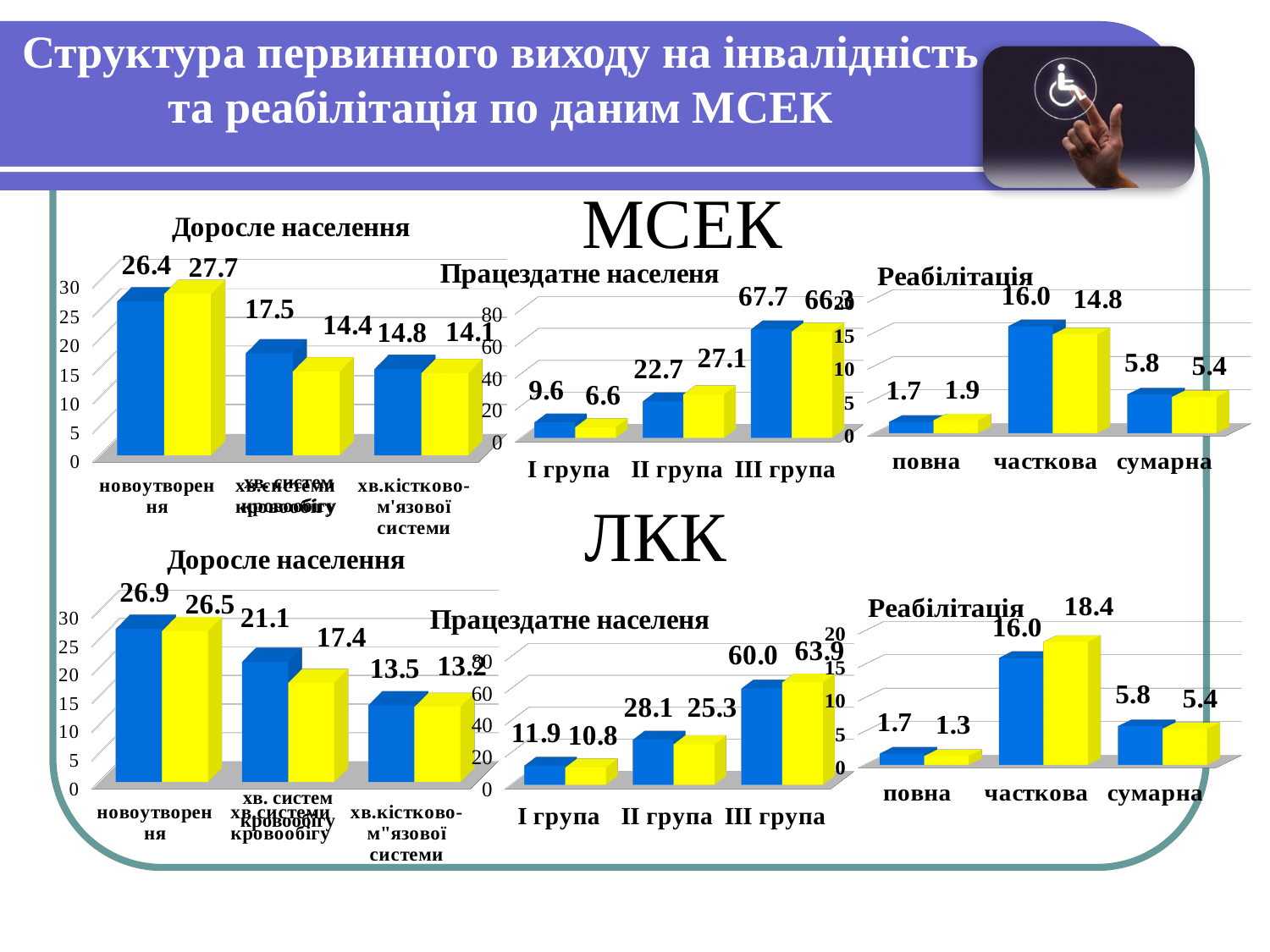
In the top-right chart 'Реабілітація' (МСЕК row), what is the value of the yellow bar for 'часткова'? 14.8 In the bottom-middle chart 'Працездатне населеня' (ЛКК row), how many categories are shown on the x axis? 3 In the top-left chart 'Доросле населення' (МСЕК row), what is the value of the blue bar for 'новоутворення'? 26.4 In the top-left chart 'Доросле населення' (МСЕК row), what is the value of the yellow bar for 'хв. систем кровообігу'? 14.4 In the top-right chart 'Реабілітація' (МСЕК row), which category has the lowest values? повна In the bottom-middle chart 'Працездатне населеня' (ЛКК row), what is the value of the yellow bar for 'III група'? 63.9 In the bottom-left chart 'Доросле населення' (ЛКК row), is the blue bar for 'новоутворення' larger or smaller than the yellow bar? larger In the top-middle chart 'Працездатне населеня' (МСЕК row), which category has the highest blue bar? III група In the bottom-right chart 'Реабілітація' (ЛКК row), what is the value of the yellow bar for 'часткова'? 18.4 In the top-middle chart 'Працездатне населеня' (МСЕК row), what is the difference between the yellow and blue bars for 'II група'? 4.4 What type of chart is used for 'Реабілітація' in the ЛКК row (bottom right)? bar chart In the bottom-left chart 'Доросле населення' (ЛКК row), what is the value of the blue bar for 'хв. систем кровообігу'? 21.1